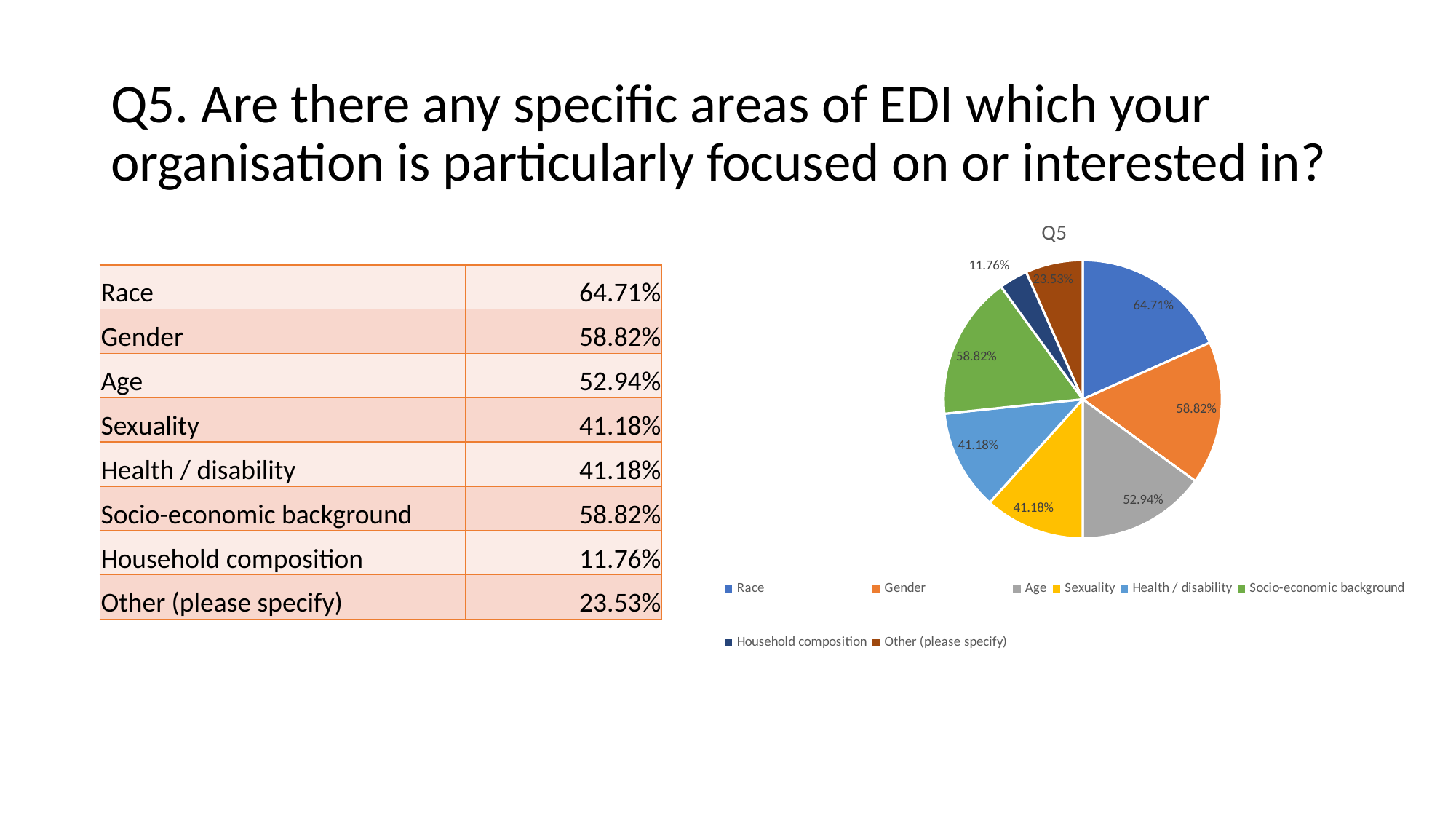
What is the value for Household composition in the chart? 11.76% Which is larger, the value for Gender or the value for Sexuality? Gender Which category has the highest value in the chart? Race What is the title of the chart? Q5 What is the value for Other (please specify) in the chart? 23.53% What is the value for Race in the chart? 64.71% Which category has the lowest value in the chart? Household composition What is the value for Age in the chart? 52.94% What is the difference between the values for Race and Age? 11.77% What type of chart is shown on the slide? pie chart What colour is the Socio-economic background slice in the chart? green How many categories does the legend of the chart list? 8